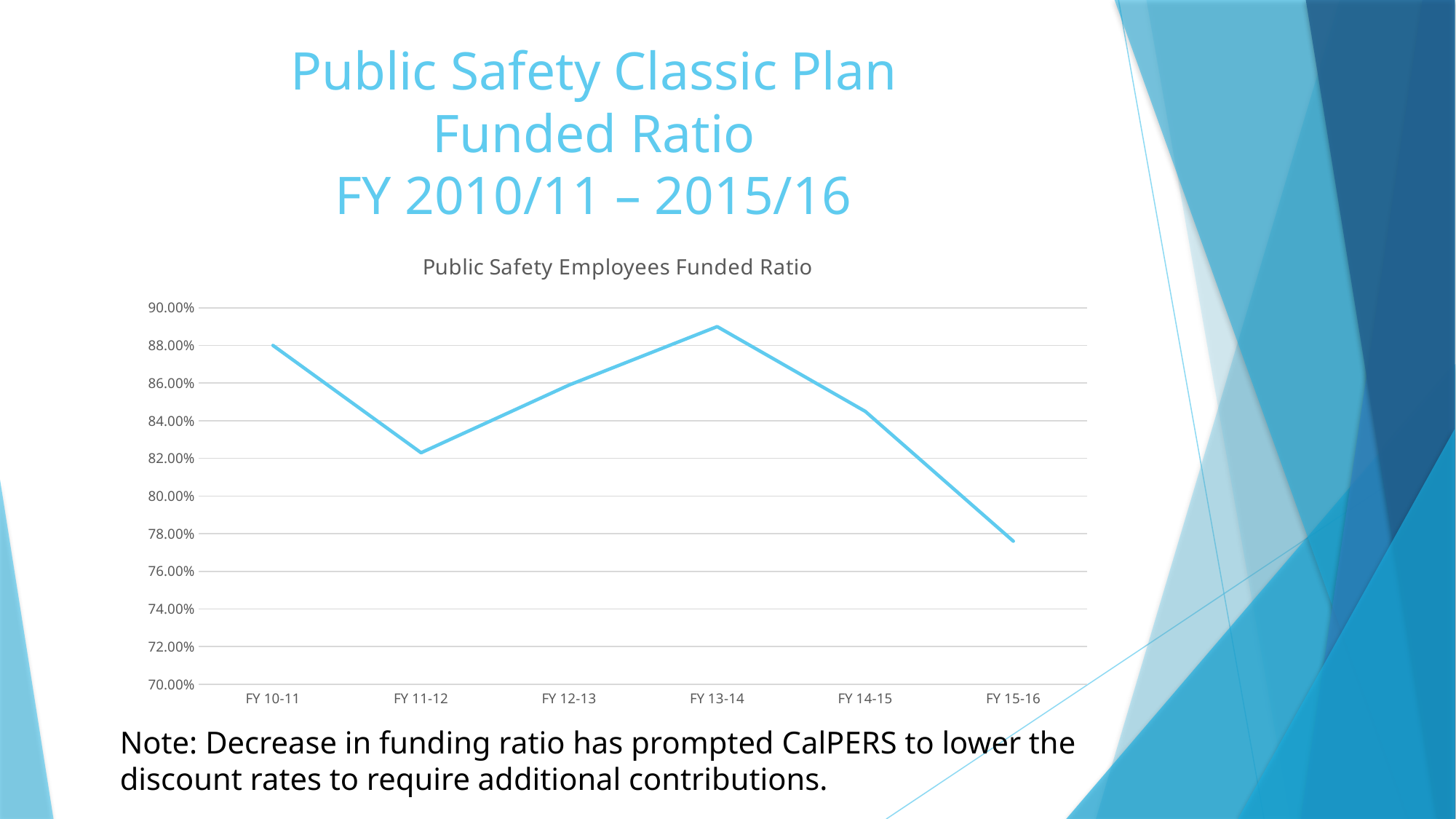
Does the funded ratio rise or fall from FY 13-14 to FY 15-16? fall What kind of chart is shown on the slide? line chart Which fiscal year has a higher funded ratio, FY 12-13 or FY 11-12? FY 12-13 What is the title shown above the chart? Public Safety Employees Funded Ratio Is the funded ratio for FY 14-15 greater or less than 86.00%? less Which fiscal year has the highest funded ratio in the chart? FY 13-14 Which fiscal year has the lowest funded ratio in the chart? FY 15-16 Is the funded ratio for FY 13-14 greater or less than 88.00%? greater Is the funded ratio for FY 15-16 greater or less than 78.00%? less How many fiscal years are plotted on the x axis of the chart? 6 Which fiscal year has a higher funded ratio, FY 10-11 or FY 15-16? FY 10-11